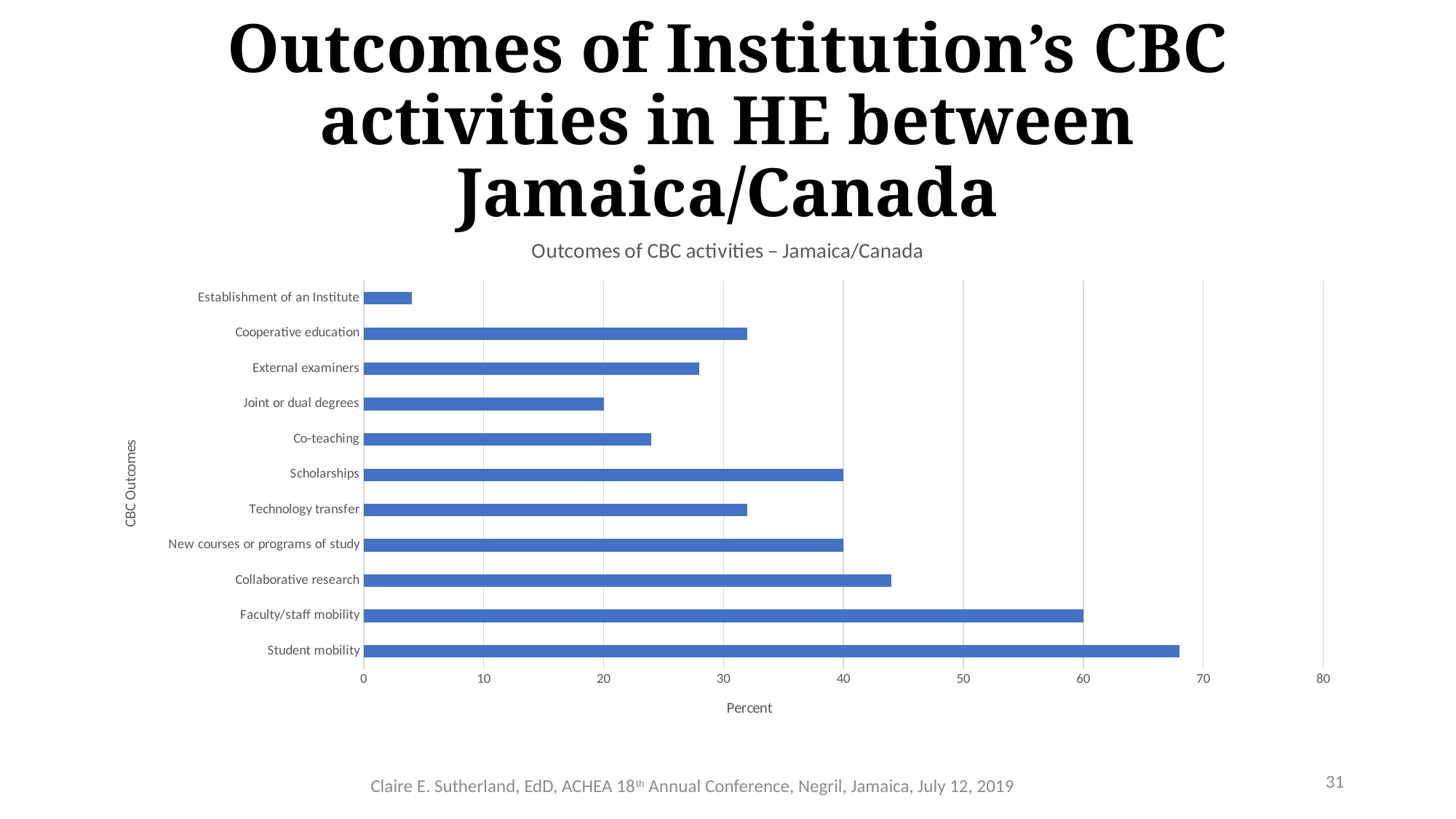
Is the value for Student mobility greater or less than 60? greater How many CBC outcome categories are plotted in the chart? 11 Which CBC outcome has the lowest percentage? Establishment of an Institute What is the percentage for Joint or dual degrees? 20 What kind of chart is shown on the slide? bar chart What is the percentage for Faculty/staff mobility? 60 Is the value for Establishment of an Institute greater or less than 10? less Which CBC outcome has the highest percentage? Student mobility What is the percentage for Scholarships? 40 Which is larger, the value for Collaborative research or the value for Co-teaching? Collaborative research What is the label of the horizontal axis of the chart? Percent What is the difference between the percentages for Faculty/staff mobility and Joint or dual degrees? 40